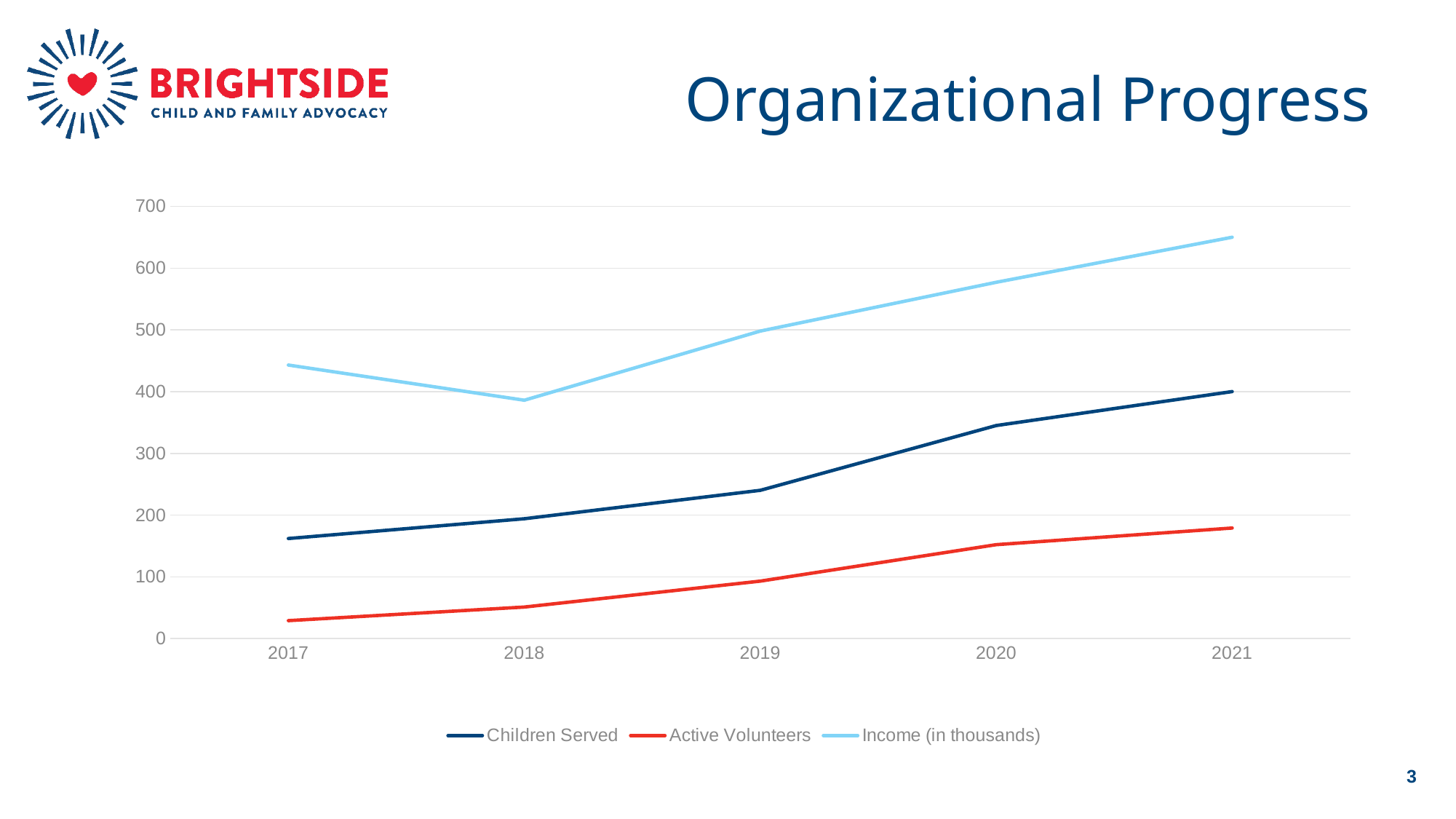
Is the value for Income (in thousands) in 2018 greater or less than 400? less Which is larger in 2018: Children Served or Active Volunteers? Children Served Which series is drawn in red? Active Volunteers What kind of chart is shown on the slide? line chart Does the Children Served line rise or fall from 2017 to 2021? rises How many series does the legend list? 3 Which series has the lowest value in 2017? Active Volunteers Which series has the highest value in 2021? Income (in thousands) How many years are shown on the x axis? 5 What is the title of the slide containing the chart? Organizational Progress Is the value for Children Served in 2020 greater or less than 300? greater